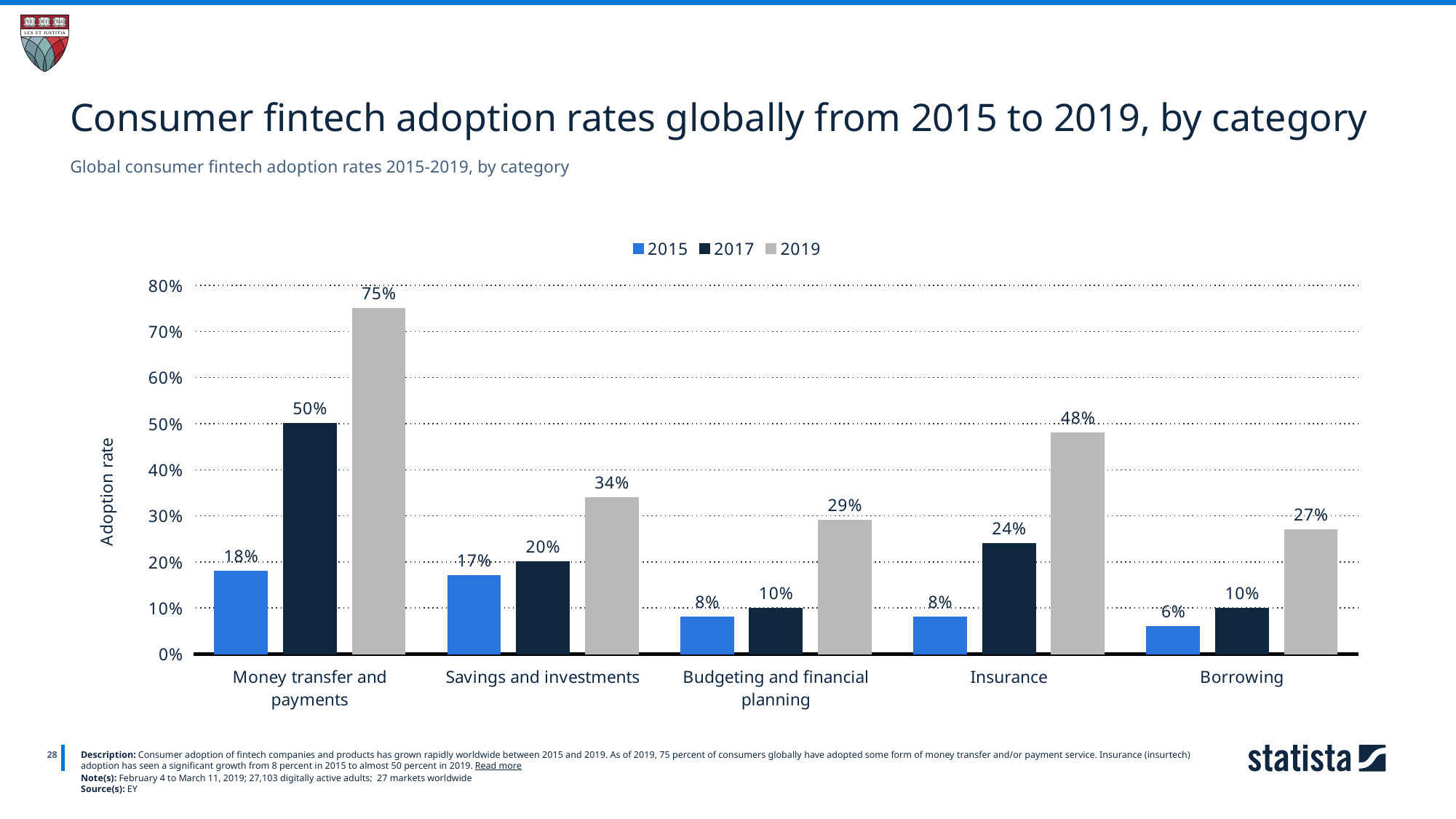
Which was higher in 2019: the adoption rate for Savings and investments or for Budgeting and financial planning? Savings and investments What was the adoption rate for Insurance in 2017? 24% Which category had the lowest adoption rate in 2015? Borrowing Which category had the highest adoption rate in 2019? Money transfer and payments What type of chart is shown on the slide? Bar chart What is the label on the y axis of the chart? Adoption rate For Money transfer and payments, did the adoption rate rise or fall from 2015 to 2019? Rise How many series does the legend list? 3 By how many percentage points did the adoption rate for Insurance increase from 2017 to 2019? 24 percentage points What was the fintech adoption rate for Money transfer and payments in 2019? 75% What was the adoption rate for Borrowing in 2015? 6% How many categories are shown on the x axis? 5